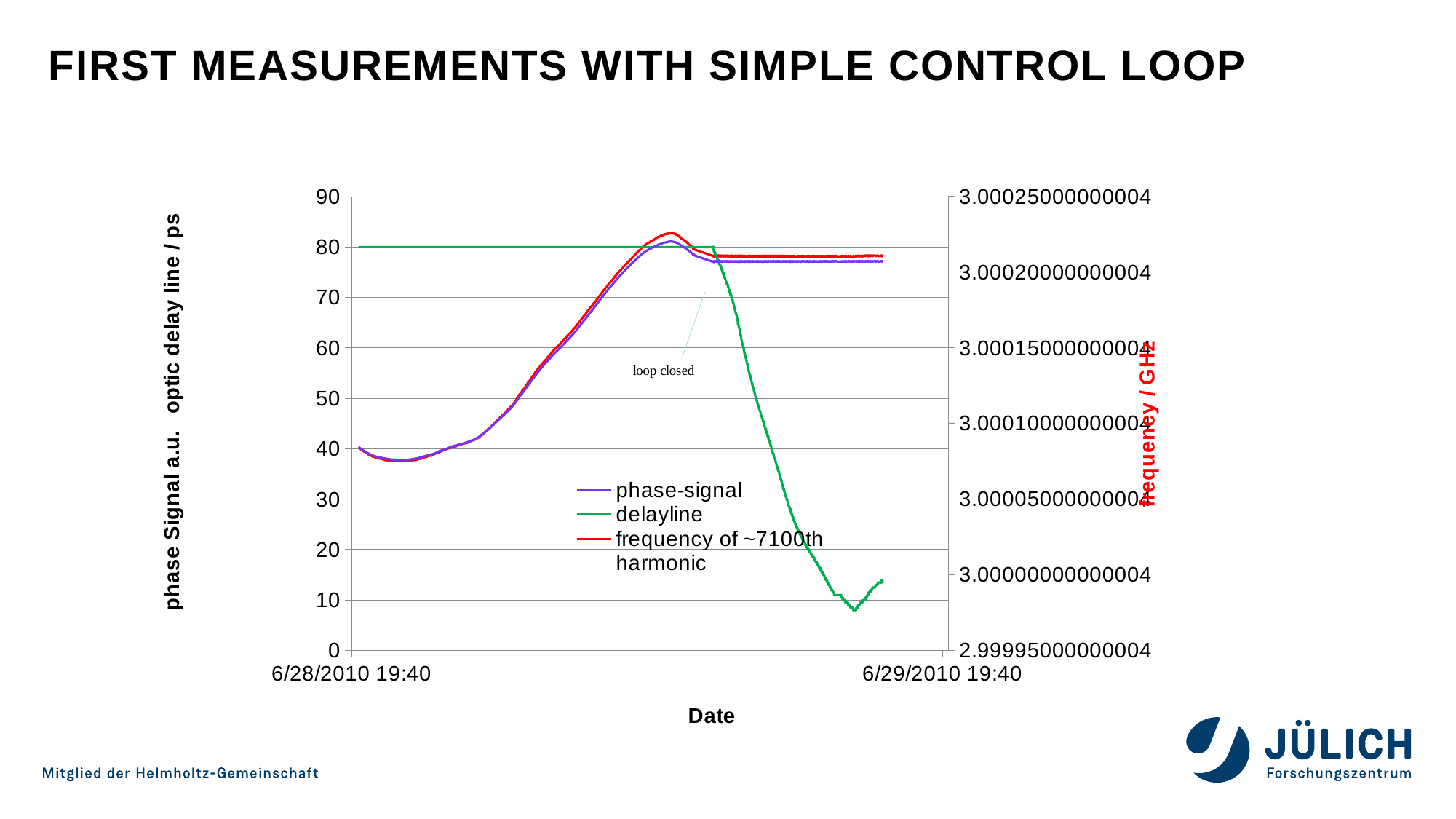
Is the final value of the delayline series greater or less than 20? less What kind of chart is shown on the slide? line chart How many series does the legend list? 3 Does the phase-signal series rise or fall between the start of the chart and the point marked 'loop closed'? rise What is the last date shown on the x axis? 6/29/2010 19:40 What value does the delayline series hold before the loop is closed? 80 Does the delayline series rise or fall after the point marked 'loop closed'? fall What is the title of the x axis? Date What is the first date shown on the x axis? 6/28/2010 19:40 Which series is drawn in green? delayline Is the peak value of the phase-signal series greater or less than 70? greater Is the lowest value of the delayline series greater or less than 20? less